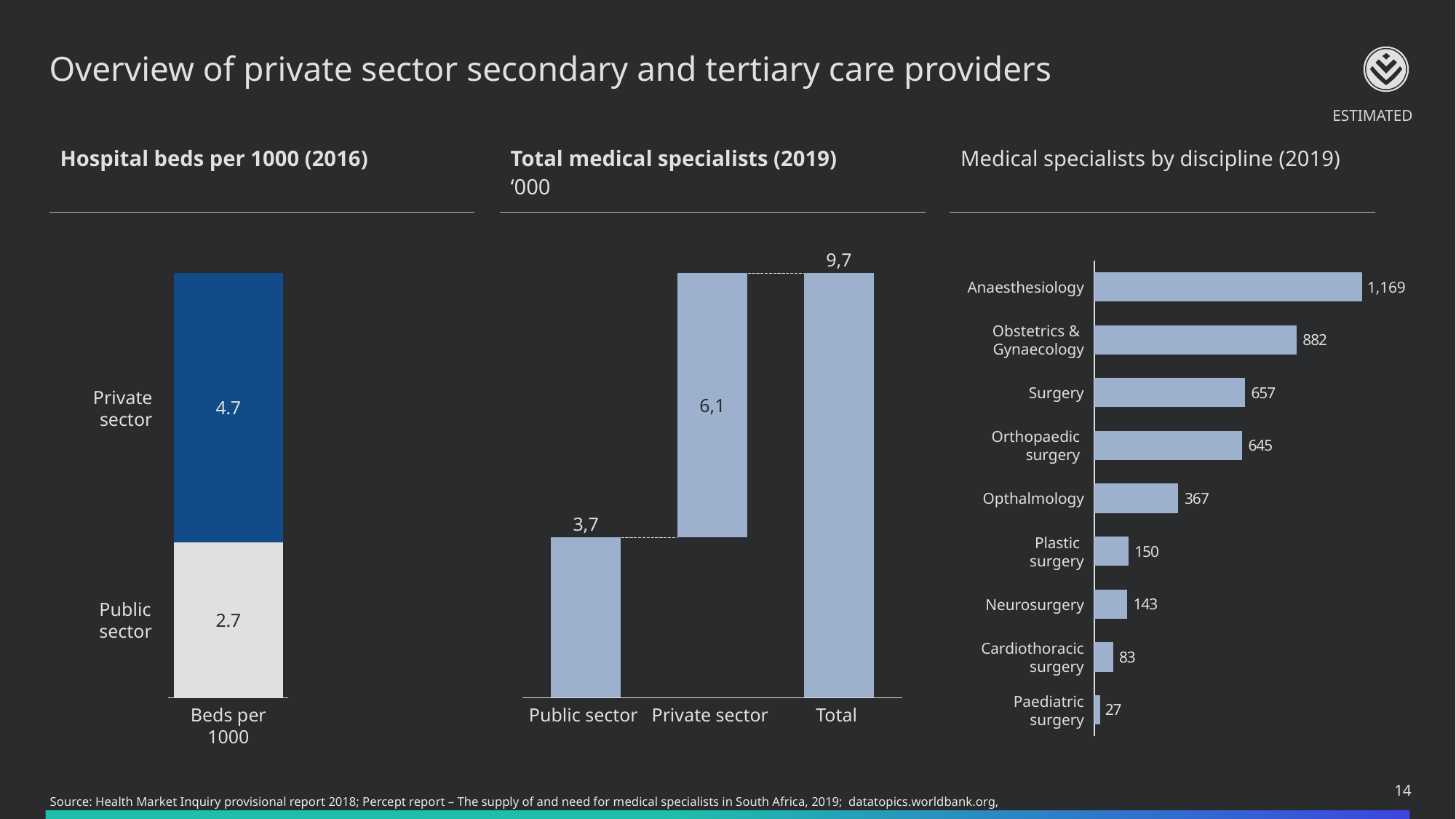
In the 'Medical specialists by discipline (2019)' chart, which discipline has the lowest value? Paediatric surgery In the 'Total medical specialists (2019)' chart, what is the value for the public sector? 3,7 In the 'Total medical specialists (2019)' chart, what is the difference between the private sector and public sector values? 2,4 In the 'Hospital beds per 1000 (2016)' chart, what is the value for the private sector? 4.7 What kind of chart is the 'Medical specialists by discipline (2019)' chart? Bar chart In the 'Hospital beds per 1000 (2016)' chart, what is the total of the stacked bar? 7.4 In the 'Medical specialists by discipline (2019)' chart, how many disciplines are shown? 9 In the 'Hospital beds per 1000 (2016)' chart, which sector has the larger value, private or public? Private sector In the 'Medical specialists by discipline (2019)' chart, what is the difference between Surgery and Orthopaedic surgery? 12 In the 'Total medical specialists (2019)' chart, what is the value for Total? 9,7 In the 'Medical specialists by discipline (2019)' chart, which discipline has the highest value? Anaesthesiology In the 'Medical specialists by discipline (2019)' chart, what is the value for Opthalmology? 367